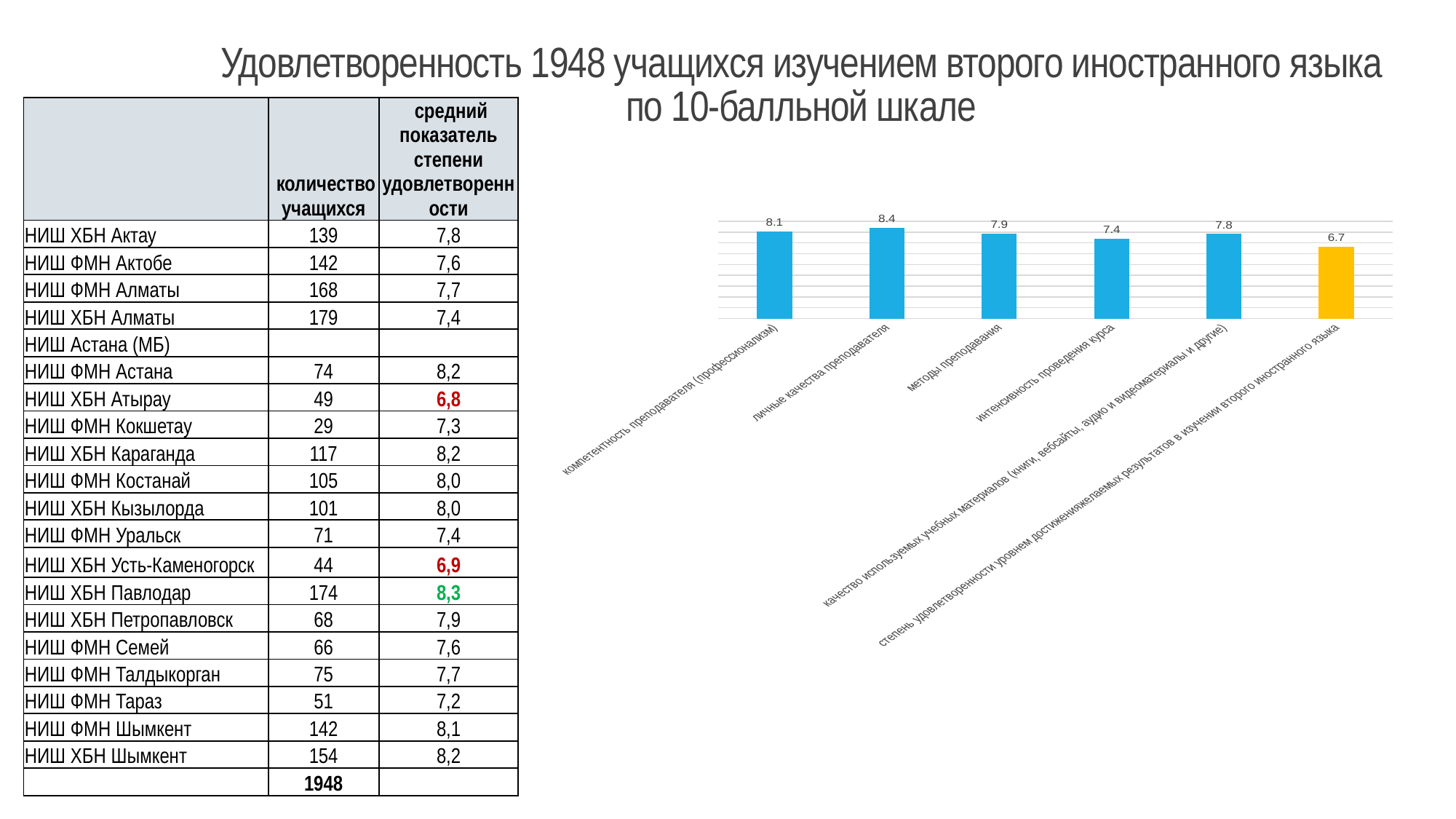
Which category has the highest value in the bar chart? личные качества преподавателя What type of chart is shown on the right side of the slide? bar chart In the bar chart, what is the value for 'методы преподавания'? 7.9 In the bar chart, which is larger: the value for 'методы преподавания' or the value for 'качество используемых учебных материалов'? методы преподавания How many bars does the chart on the right show? 6 In the bar chart, what is the difference between the values for 'личные качества преподавателя' and 'интенсивность проведения курса'? 1.0 In the bar chart, what is the value for 'компетентность преподавателя (профессионализм)'? 8.1 Which category has the lowest value in the bar chart? степень удовлетворенности уровнем достижения желаемых результатов в изучении второго иностранного языка In the bar chart, what is the value of the yellow bar? 6.7 In the bar chart, which bar is coloured differently (yellow) from the others? степень удовлетворенности уровнем достижения желаемых результатов в изучении второго иностранного языка In the bar chart, what is the value for 'интенсивность проведения курса'? 7.4 In the bar chart, what is the value for 'личные качества преподавателя'? 8.4